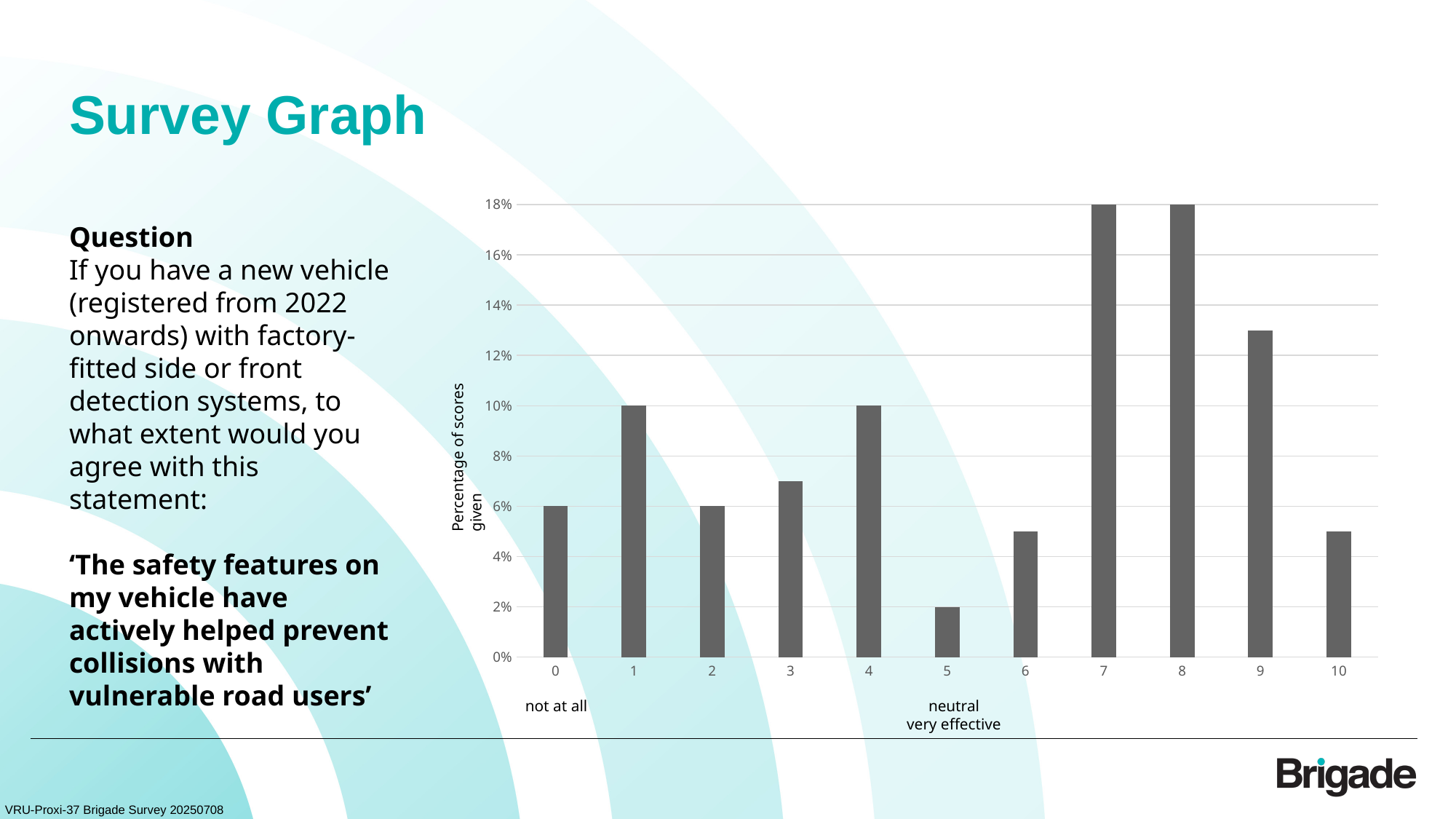
Is the value for score 10 greater or less than 6%? less What is the difference in percentage of scores given between score 7 and score 5? 16% What percentage of scores given was for a score of 0? 6% What percentage of scores given was for a score of 5? 2% How many score categories are shown on the x axis? 11 What type of chart is shown on the slide? bar chart Which received a higher percentage of scores given, score 4 or score 6? 4 What percentage of scores given was for a score of 7? 18% Is the value for score 9 greater or less than 12%? greater Which score received the lowest percentage of scores given? 5 Is the value for score 3 greater or less than 8%? less What percentage of scores given was for a score of 1? 10%